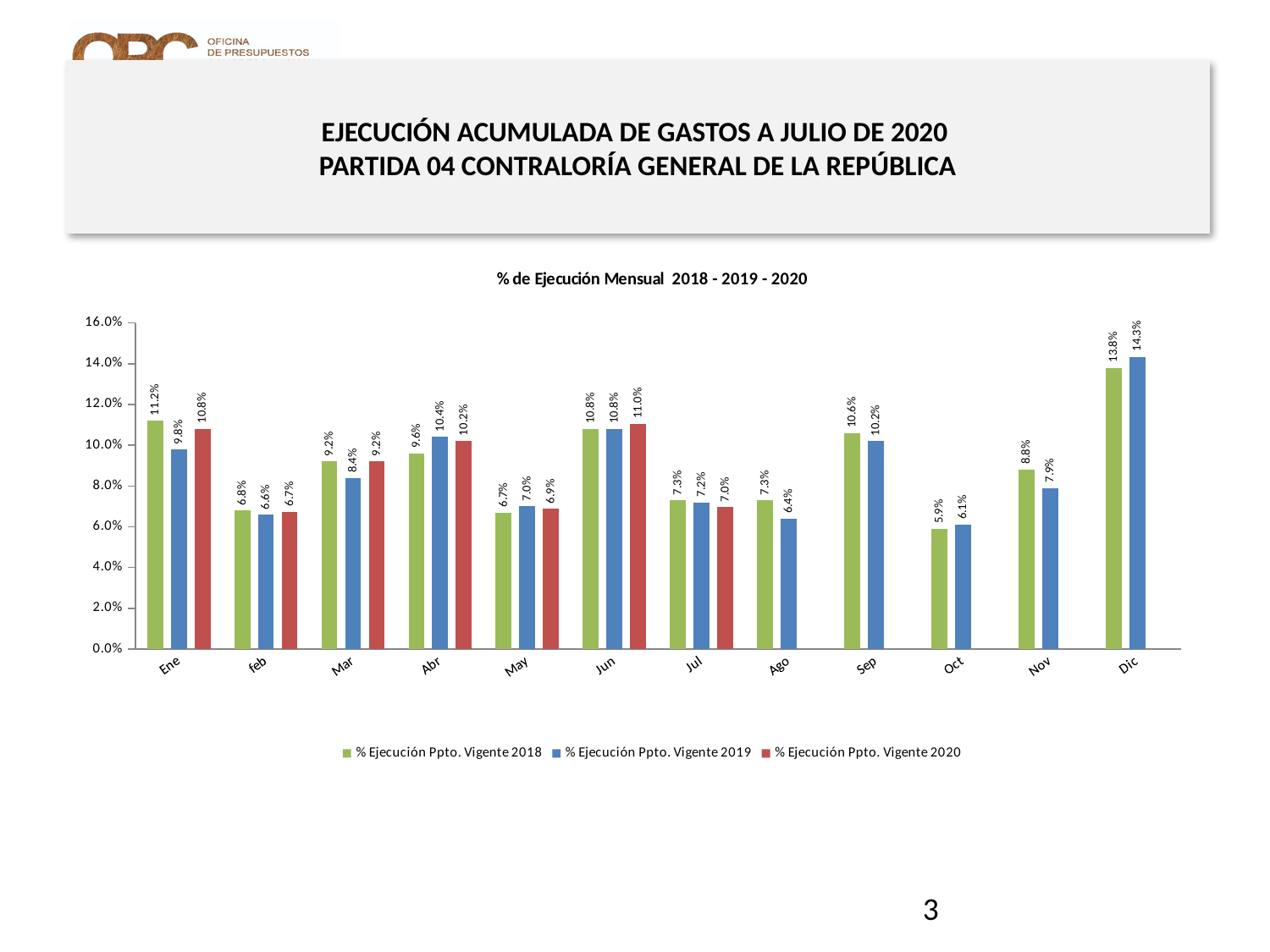
Which is larger for Ene: the 2018 value or the 2019 value? 2018 What is the title of the chart? % de Ejecución Mensual 2018 - 2019 - 2020 How many series does the legend list? 3 What is the value for Abr in the % Ejecución Ppto. Vigente 2018 series? 9.6% What is the difference between the 2019 and 2018 values for Dic? 0.5% Which month has the highest value in the % Ejecución Ppto. Vigente 2018 series? Dic What is the value for Ene in the % Ejecución Ppto. Vigente 2020 series? 10.8% What is the value for Dic in the % Ejecución Ppto. Vigente 2019 series? 14.3% What kind of chart is shown on the slide? Bar chart Is the value for Sep in the 2018 series greater or less than 10.0%? greater Which month has the lowest value in the % Ejecución Ppto. Vigente 2019 series? Oct How many months are shown on the x axis? 12